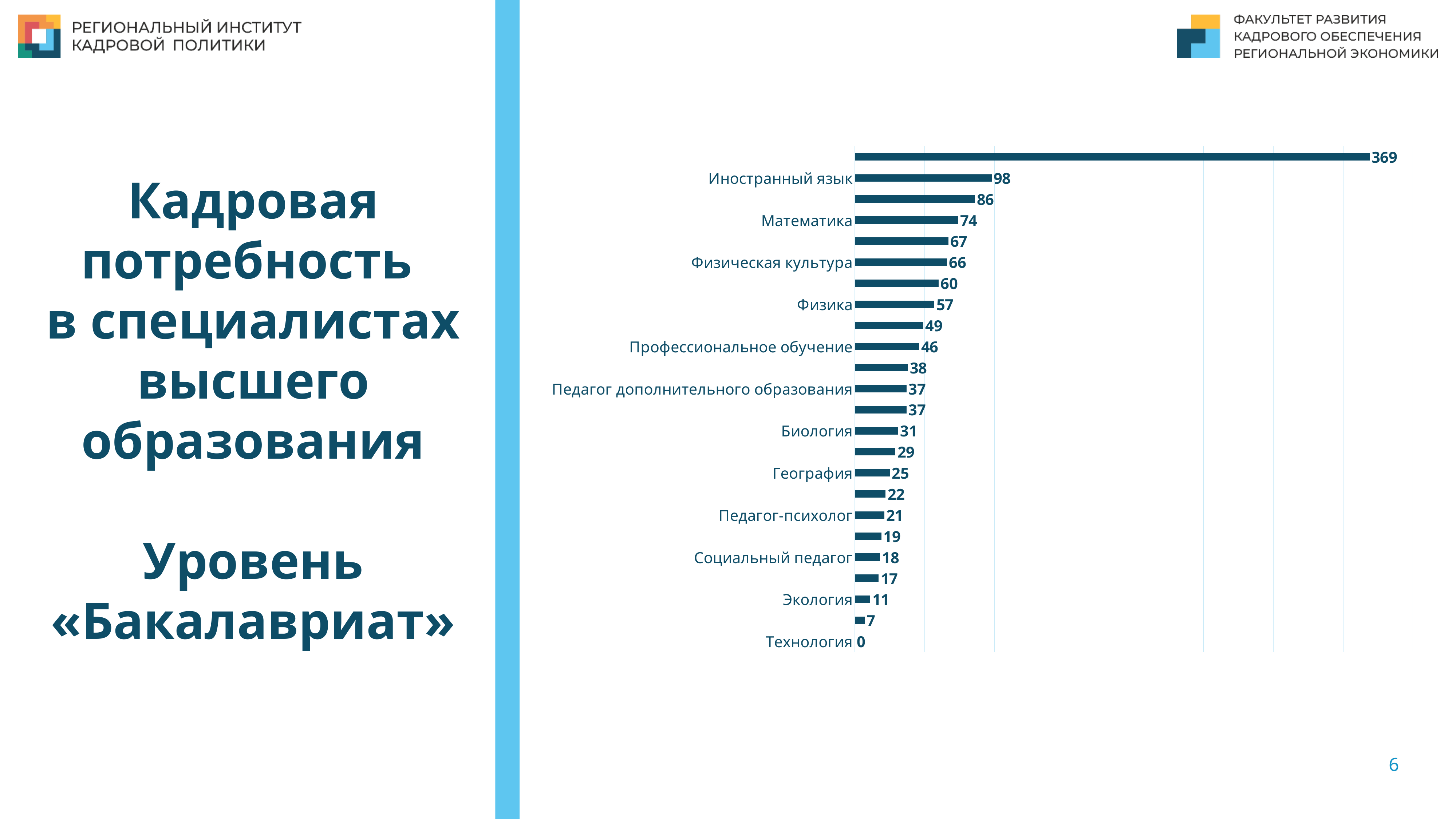
What is the value for Иностранный язык? 98 What is the value for Педагог дополнительного образования? 37 What is the value for Профессиональное обучение? 46 What is the difference between the values for Иностранный язык and Математика? 24 What is the largest value shown on the chart? 369 What is the value for Физическая культура? 66 What kind of chart is shown on the slide? Bar chart Which is larger, the value for Физика or the value for Биология? Физика How many bars are plotted on the chart? 23 Which labelled category has the lowest value? Технология What is the value for Математика? 74 What is the value for Экология? 11